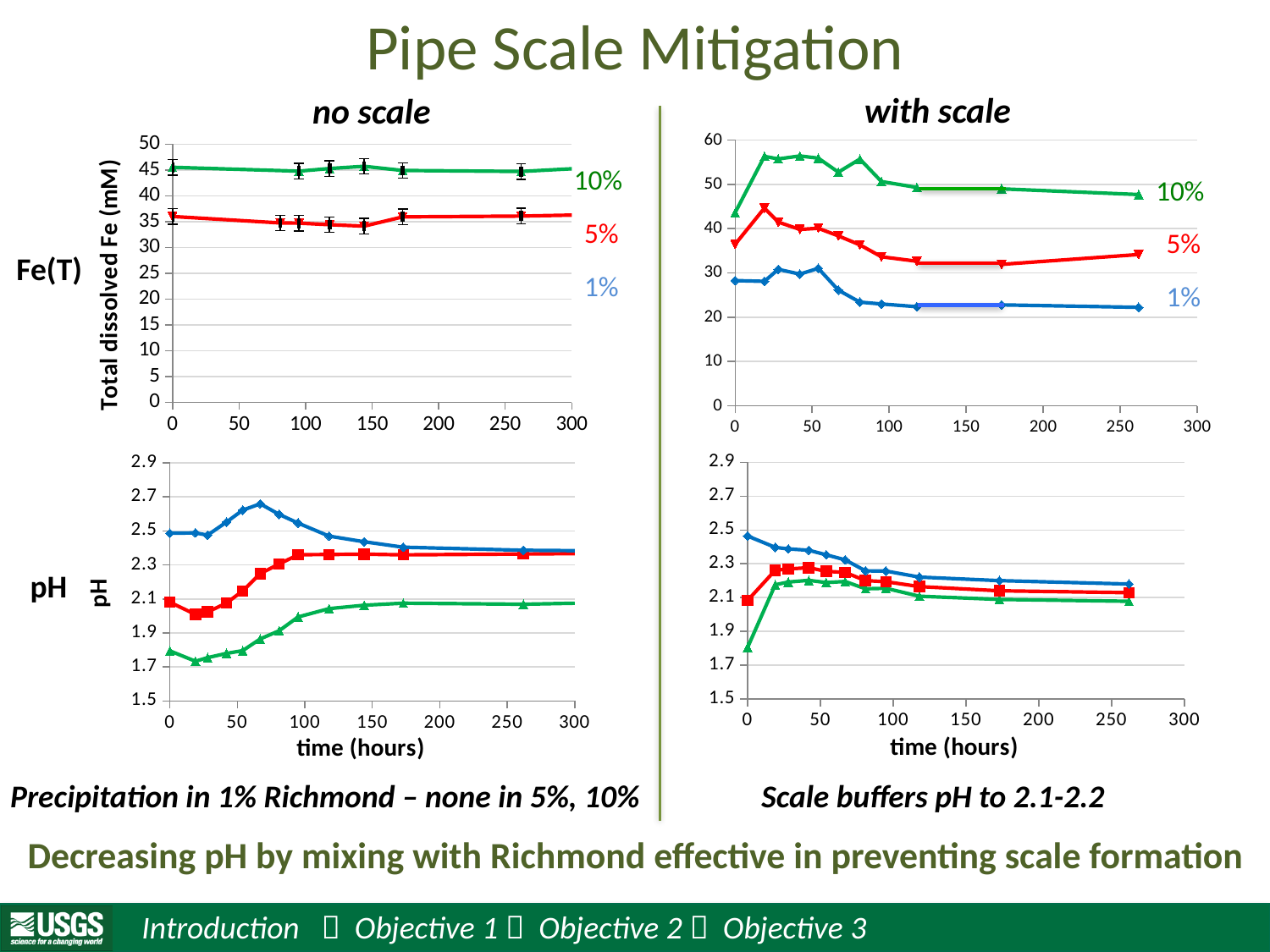
In the top-right 'with scale' Fe(T) chart, is the peak value of the 10% series greater or less than 50? greater In the top-right 'with scale' Fe(T) chart, which is larger at about 260 hours, the 5% series or the 1% series? 5% What kind of chart is the top-left 'no scale' Fe(T) chart? line chart In the bottom-right 'with scale' pH chart, is the value of the green series at time 0 greater or less than 1.9? less What is the x-axis label of the bottom pH charts? time (hours) In the bottom-left 'no scale' pH chart, is the lowest value of the green series greater or less than 1.9? less In the top-right 'with scale' Fe(T) chart, which series has the lowest values? 1% In the top-left 'no scale' Fe(T) chart, which series has the highest values? 10% In the top-right 'with scale' Fe(T) chart, does the 10% series rise or fall between about 50 and 260 hours? fall